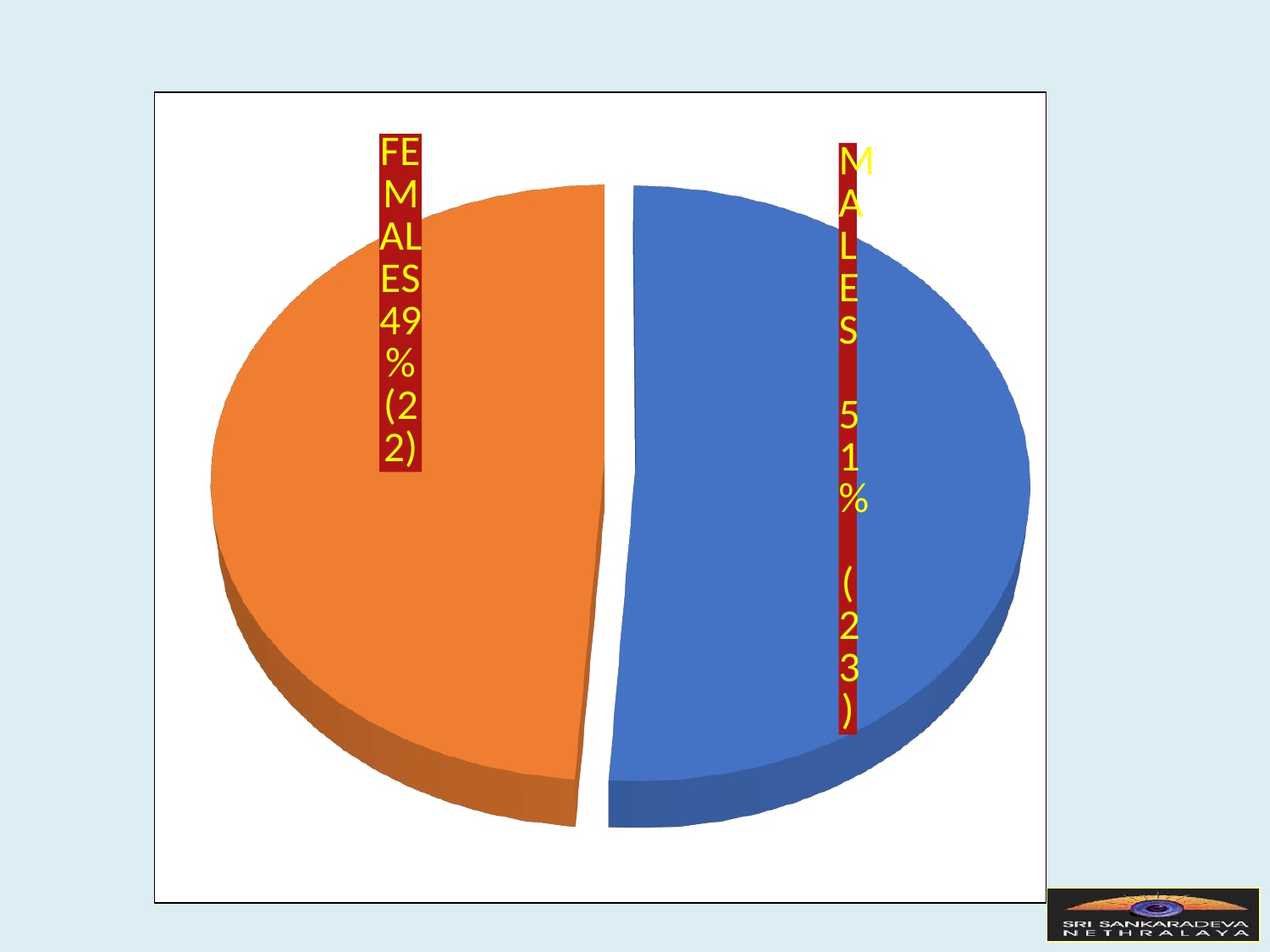
What kind of chart is shown on the slide? pie chart What is the total count of MALES and FEMALES combined, using the numbers in parentheses? 45 How many slices does the pie chart have? 2 What colour is the MALES slice? blue What percentage of the pie is labelled FEMALES? 49% Which category has the largest share of the pie? MALES Which slice is larger, MALES or FEMALES? MALES What is the difference in percentage points between the MALES and FEMALES slices? 2% Which category has the smallest share of the pie? FEMALES What percentage of the pie is labelled MALES? 51% What count is shown in parentheses for FEMALES? 22 What count is shown in parentheses for MALES? 23